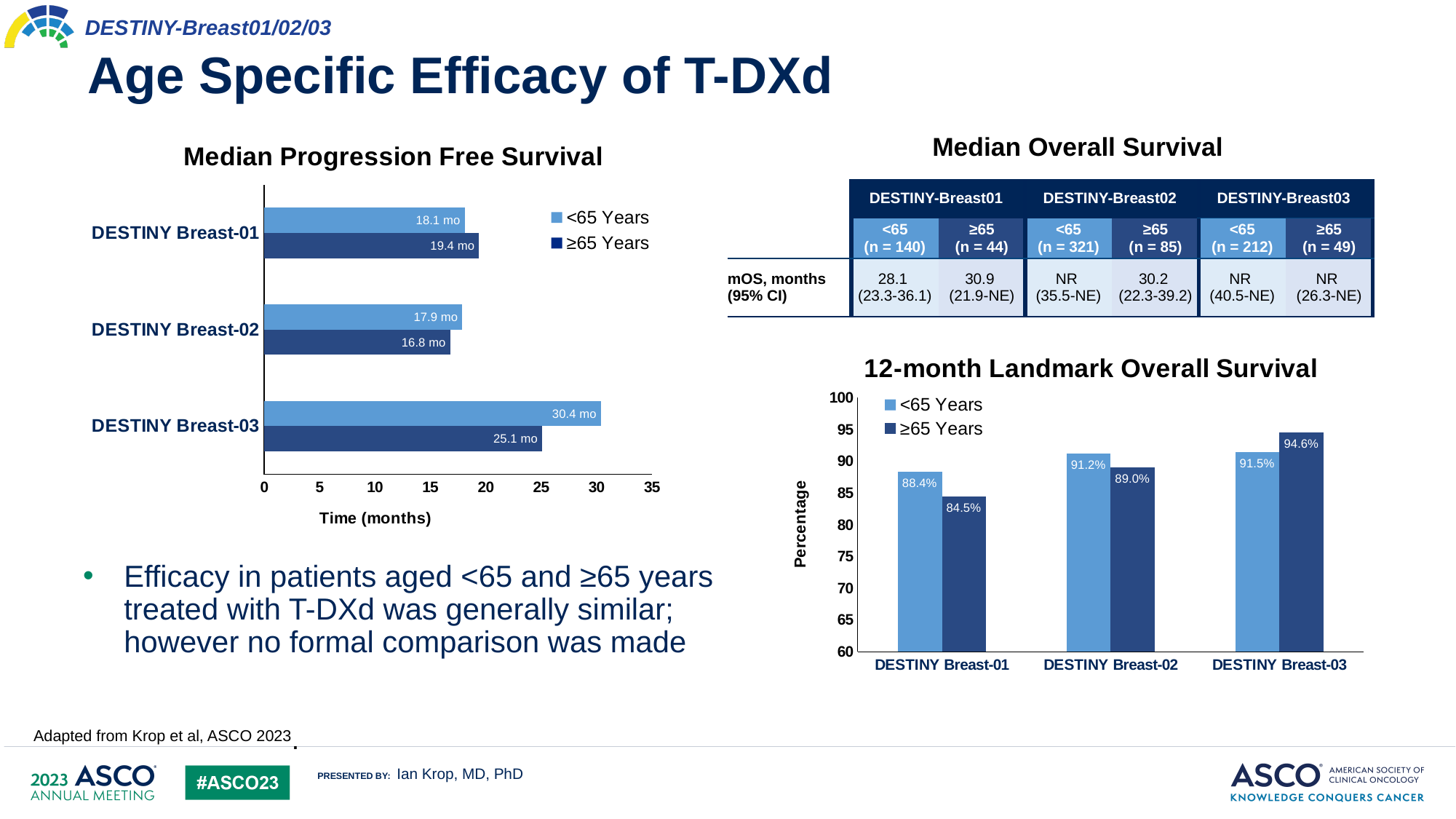
In the 12-month Landmark Overall Survival chart, which bar has the lowest value? ≥65 Years, DESTINY Breast-01 How many series does the legend of the Median Progression Free Survival chart list? 2 In the Median Progression Free Survival chart, what is the difference between the <65 Years and ≥65 Years values for DESTINY Breast-03? 5.3 mo In the Median Progression Free Survival chart, what is the value for ≥65 Years in DESTINY Breast-02? 16.8 mo In the 12-month Landmark Overall Survival chart, what is the difference between the <65 Years and ≥65 Years values for DESTINY Breast-02? 2.2% How many trials are shown on the x axis of the 12-month Landmark Overall Survival chart? 3 In the 12-month Landmark Overall Survival chart, what is the value for ≥65 Years in DESTINY Breast-03? 94.6% In the Median Progression Free Survival chart, what is the value for <65 Years in DESTINY Breast-03? 30.4 mo In the Median Progression Free Survival chart, which is larger for DESTINY Breast-01: the <65 Years value or the ≥65 Years value? ≥65 Years What kind of chart is the Median Progression Free Survival chart? Bar chart In the Median Progression Free Survival chart, which trial has the highest value for ≥65 Years? DESTINY Breast-03 In the 12-month Landmark Overall Survival chart, what is the value for <65 Years in DESTINY Breast-01? 88.4%